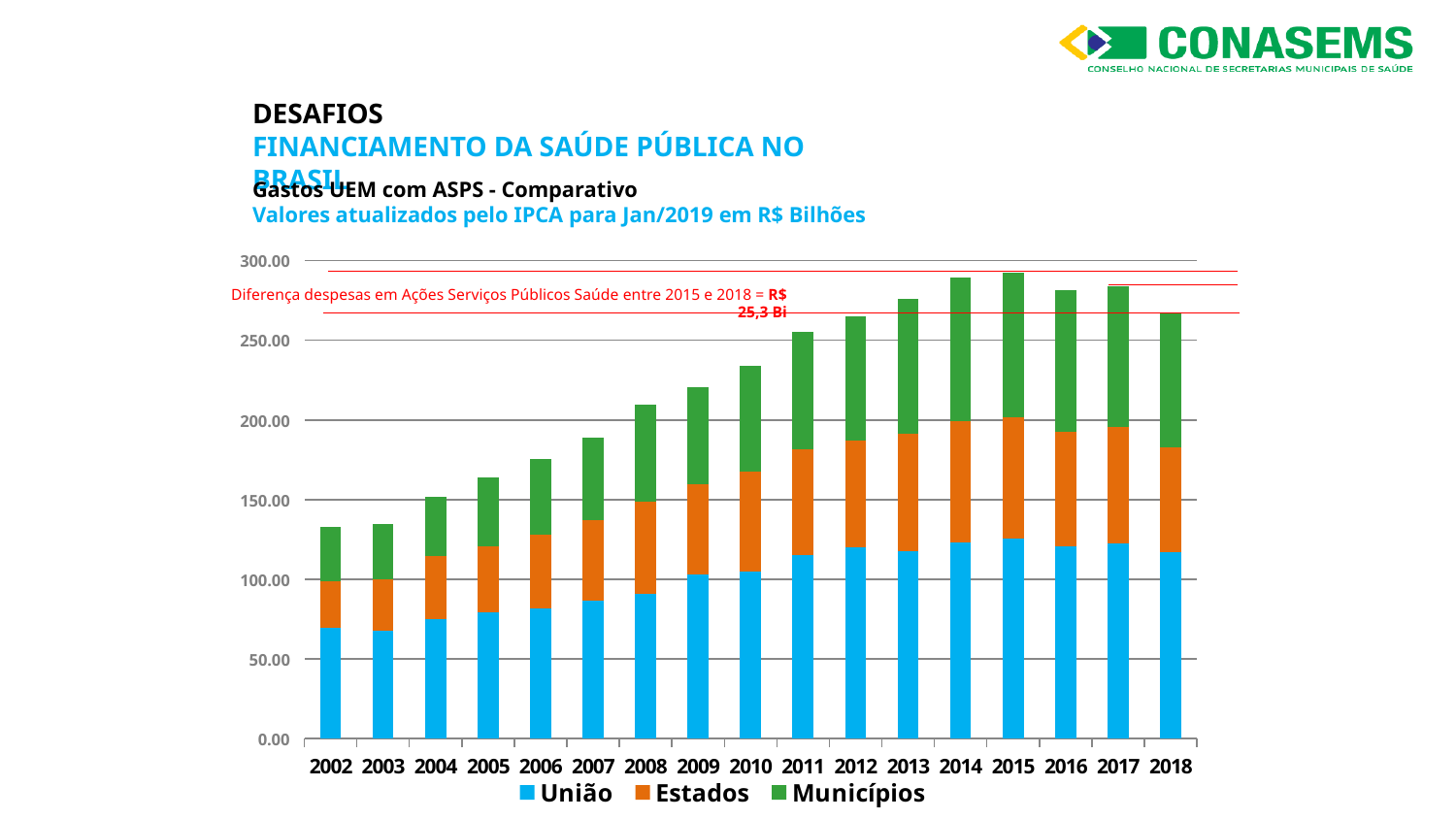
Is the total value for 2010 greater or less than 200? greater Do the total bar values generally rise or fall from 2002 to 2015? rise According to the annotation on the chart, what is the difference in ASPS spending between 2015 and 2018? R$ 25,3 Bi Which series are listed in the chart legend? União, Estados, Municípios Is the total value for 2002 greater or less than 150? less Which year has the larger total bar, 2015 or 2018? 2015 How many series does the chart legend list? 3 Which year has the highest total bar in the chart? 2015 What kind of chart is shown on the slide? stacked bar chart Is the total value for 2015 greater or less than 250? greater How many years are shown on the x axis of the chart? 17